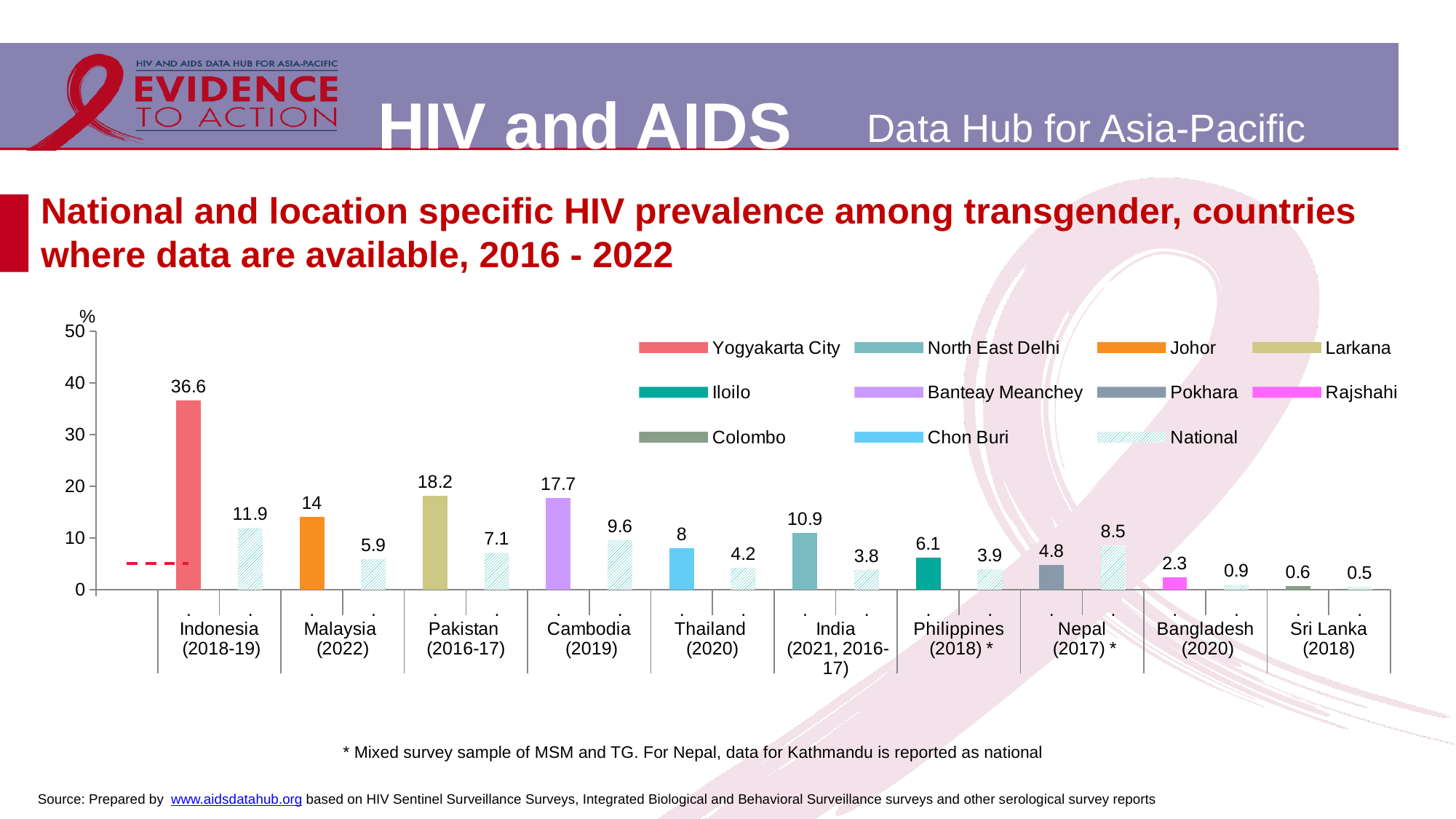
Which country has the lowest national HIV prevalence value on the chart? Sri Lanka (2018) Which legend entry is drawn with a hatched pattern? National What kind of chart is shown on the slide? Bar chart Is the value for North East Delhi greater or less than 10? greater How many series does the legend list? 11 What is the national HIV prevalence value shown for Cambodia (2019)? 9.6 Which is larger, the value for Johor or the value for Banteay Meanchey? Banteay Meanchey What is the difference between the Larkana value and the Pakistan national value? 11.1 What is the value shown for Pokhara (Nepal)? 4.8 Which location-specific site has the highest HIV prevalence on the chart? Yogyakarta City What is the HIV prevalence for Yogyakarta City (Indonesia)? 36.6 How many countries are shown on the x axis? 10